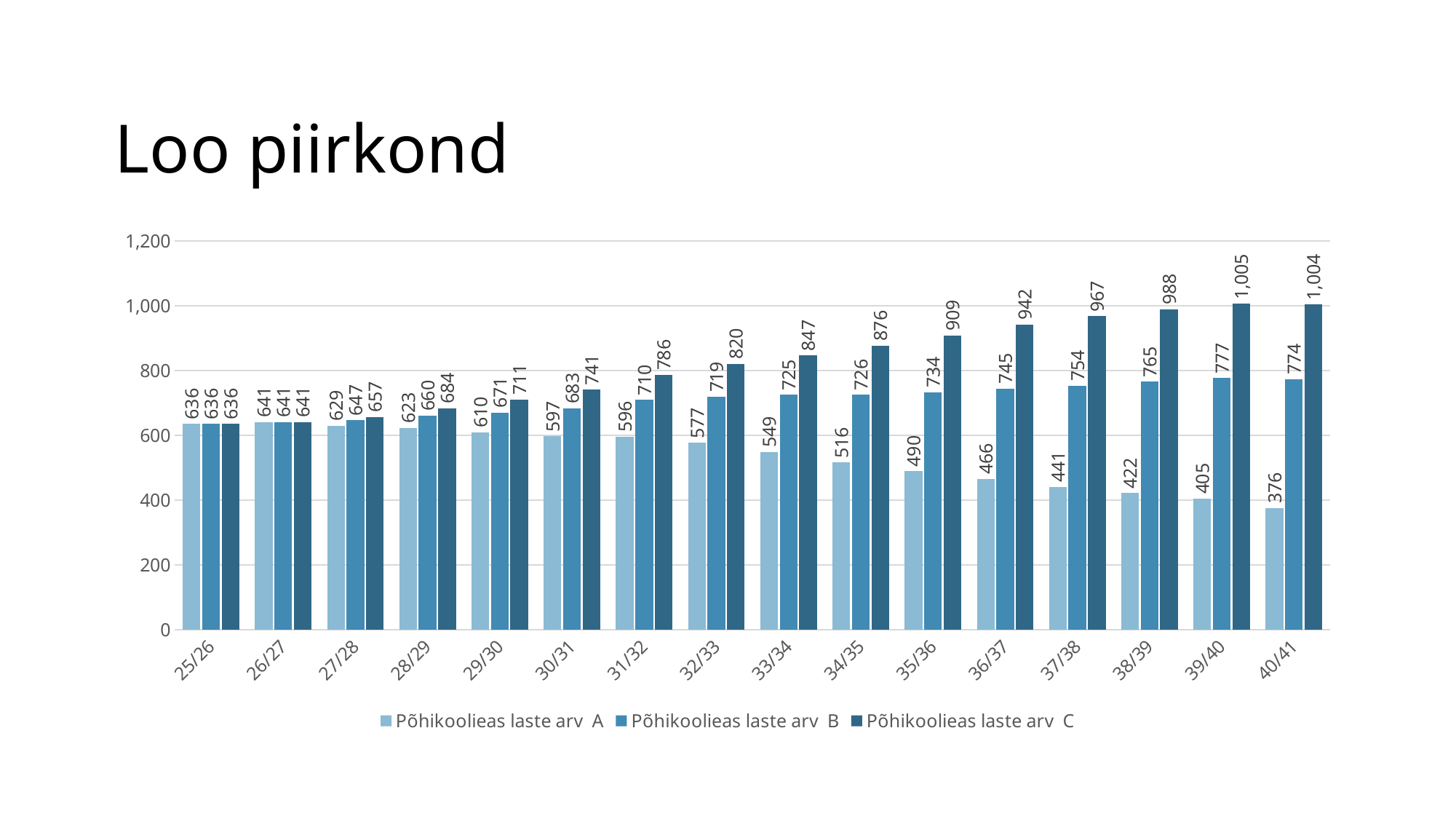
Which is larger in 33/34: Põhikoolieas laste arv B or Põhikoolieas laste arv C? Põhikoolieas laste arv C How many series does the legend list? 3 What is the value of Põhikoolieas laste arv A for 34/35? 516 What is the value of Põhikoolieas laste arv C for 39/40? 1,005 What is the difference between Põhikoolieas laste arv C and Põhikoolieas laste arv A in 40/41? 628 Is the value for Põhikoolieas laste arv A in 36/37 greater or less than 600? less In which year does Põhikoolieas laste arv C reach its highest value? 39/40 What is the value of Põhikoolieas laste arv B for 31/32? 710 Does Põhikoolieas laste arv A rise or fall from 25/26 to 40/41? fall What kind of chart is shown on the slide? bar chart How many school years are shown on the x axis? 16 In which year is Põhikoolieas laste arv A at its lowest? 40/41